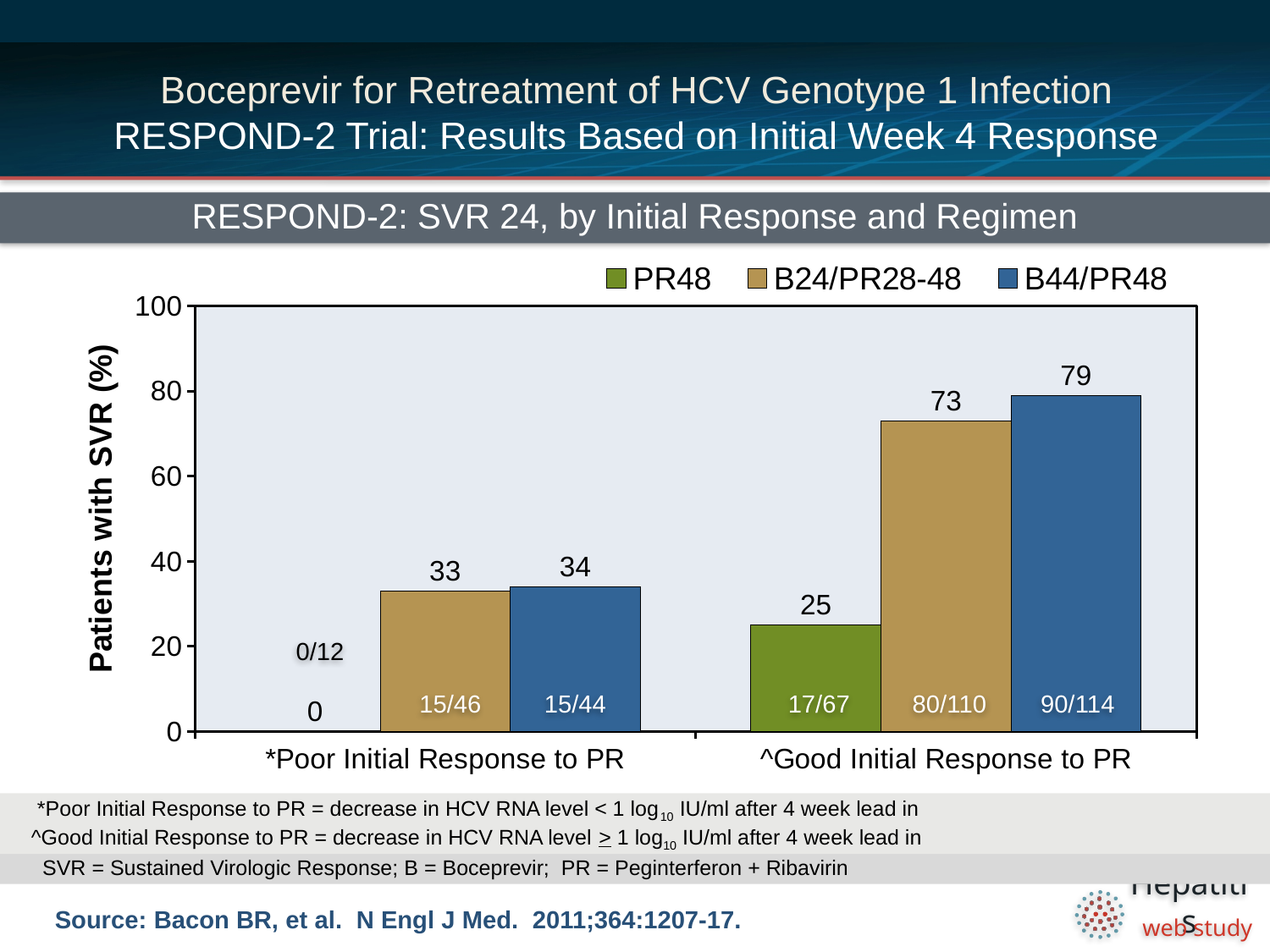
How many series does the legend list? 3 What fraction of patients is shown for the B44/PR48 bar in the poor initial response group? 15/44 Which regimen has the lowest SVR rate among patients with a poor initial response to PR? PR48 What type of chart is shown on the slide? Bar chart What is the SVR rate for PR48 among patients with a poor initial response to PR? 0 Is the SVR rate for B24/PR28-48 higher in the good initial response group or the poor initial response group? Good Initial Response to PR What is the label of the y axis? Patients with SVR (%) What is the SVR rate for B24/PR28-48 among patients with a good initial response to PR? 73 How many initial response categories are shown on the x axis? 2 Which regimen has the highest SVR rate among patients with a good initial response to PR? B44/PR48 What is the difference in SVR rate between B44/PR48 and PR48 in the good initial response group? 54 What is the SVR rate for B44/PR48 among patients with a good initial response to PR? 79